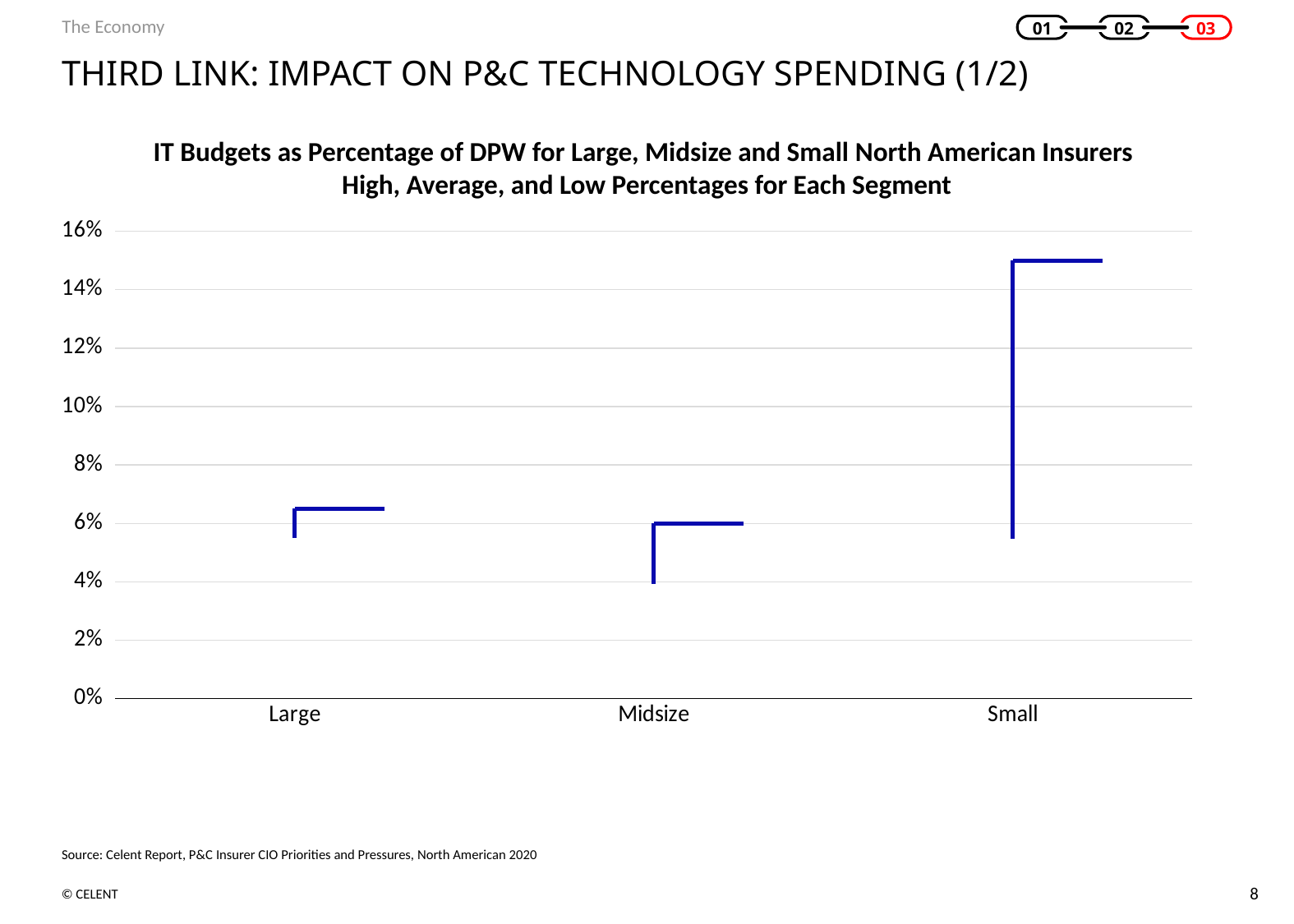
Is the low value for Midsize greater or less than 5%? less Which segment has the lowest bottom value in the chart? Midsize How many insurer segments are shown on the x axis of the chart? 3 What is the first line of the chart's title? IT Budgets as Percentage of DPW for Large, Midsize and Small North American Insurers Is the low value for Small greater or less than 6%? less Which segment shows the widest spread between its high and low percentages? Small Which has a higher bottom value, Large or Midsize? Large Which has a higher top value, Large or Small? Small Is the high value for Large greater or less than 6%? greater Which segment has the highest top value in the chart? Small